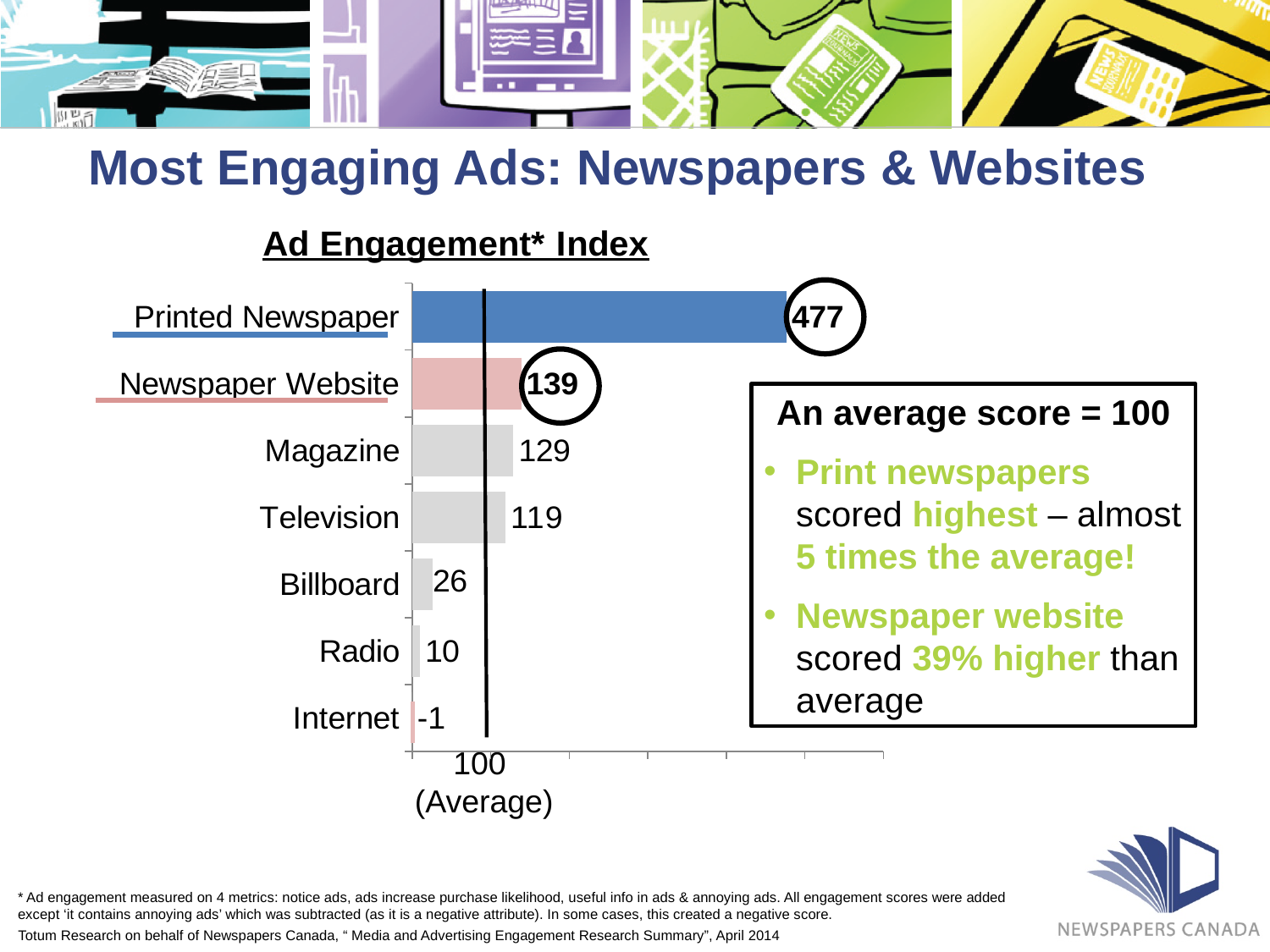
What value does the vertical line on the chart mark as the average? 100 What is the difference between the Ad Engagement Index values for Printed Newspaper and Newspaper Website? 338 Which has a higher Ad Engagement Index, Billboard or Radio? Billboard How many categories are shown in the Ad Engagement Index chart? 7 What is the Ad Engagement Index value for Newspaper Website? 139 Which category has the lowest Ad Engagement Index? Internet What kind of chart is used to show the Ad Engagement Index? Bar chart What is the Ad Engagement Index value for Television? 119 What is the Ad Engagement Index value for Internet? -1 What is the difference between the Ad Engagement Index values for Magazine and Television? 10 Which category has the highest Ad Engagement Index? Printed Newspaper What is the Ad Engagement Index value for Printed Newspaper? 477